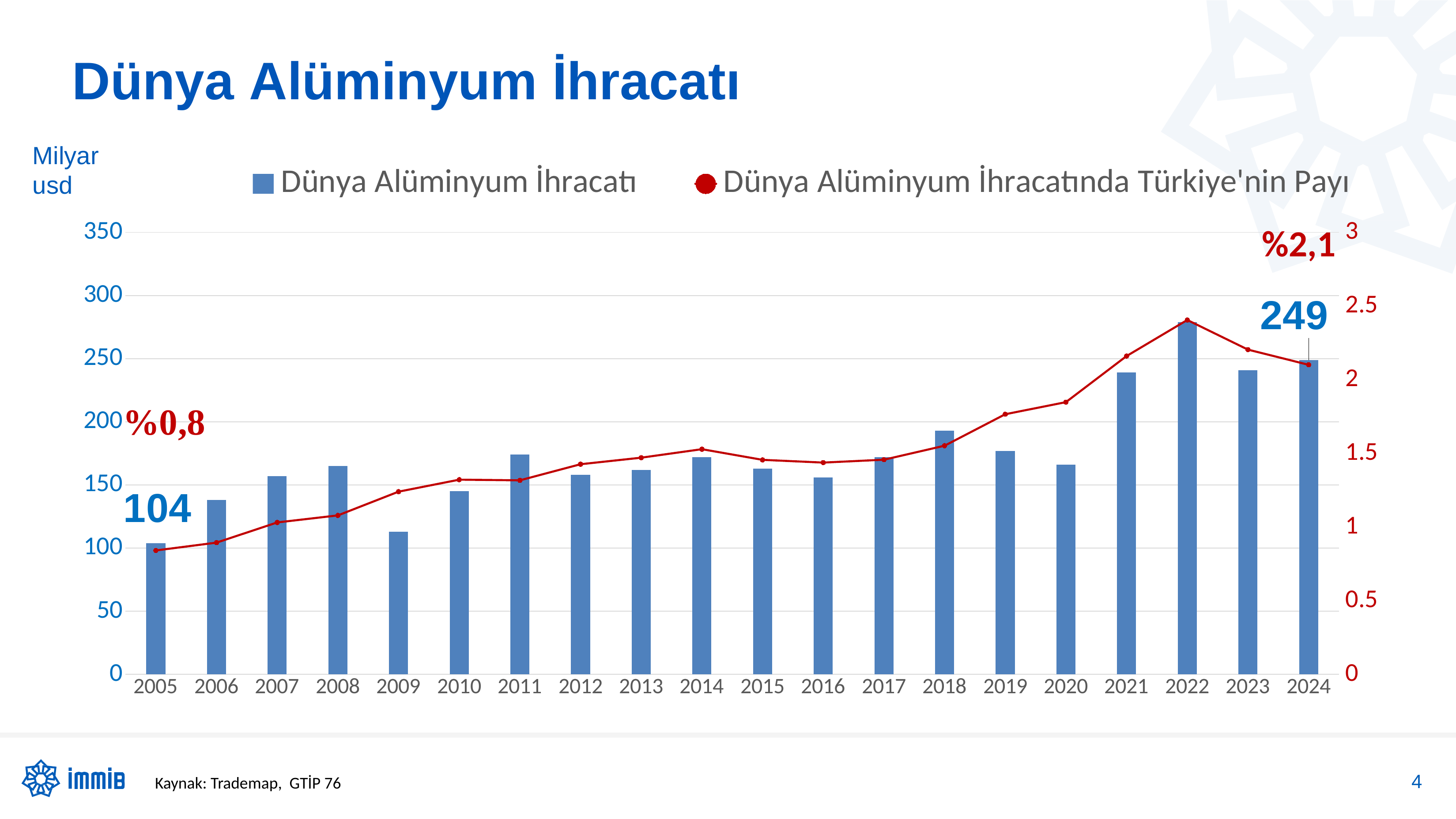
What is the value of Dünya Alüminyum İhracatı for 2005? 104 How many years are shown on the x axis of the chart? 20 What kind of chart is shown on the slide? A bar chart combined with a line chart What is Türkiye's share of world aluminium exports (Dünya Alüminyum İhracatında Türkiye'nin Payı) in 2024? %2,1 Is the value for Dünya Alüminyum İhracatı in 2022 greater or less than 250? greater Is the value for Dünya Alüminyum İhracatı in 2021 greater or less than 250? less Which year has the higher value for Dünya Alüminyum İhracatı, 2018 or 2019? 2018 What is Türkiye's share of world aluminium exports (Dünya Alüminyum İhracatında Türkiye'nin Payı) in 2005? %0,8 By how much did Dünya Alüminyum İhracatı increase from 2005 to 2024? 145 Which year has the highest bar for Dünya Alüminyum İhracatı? 2022 What is the value of Dünya Alüminyum İhracatı for 2024? 249 How many series does the legend list? 2